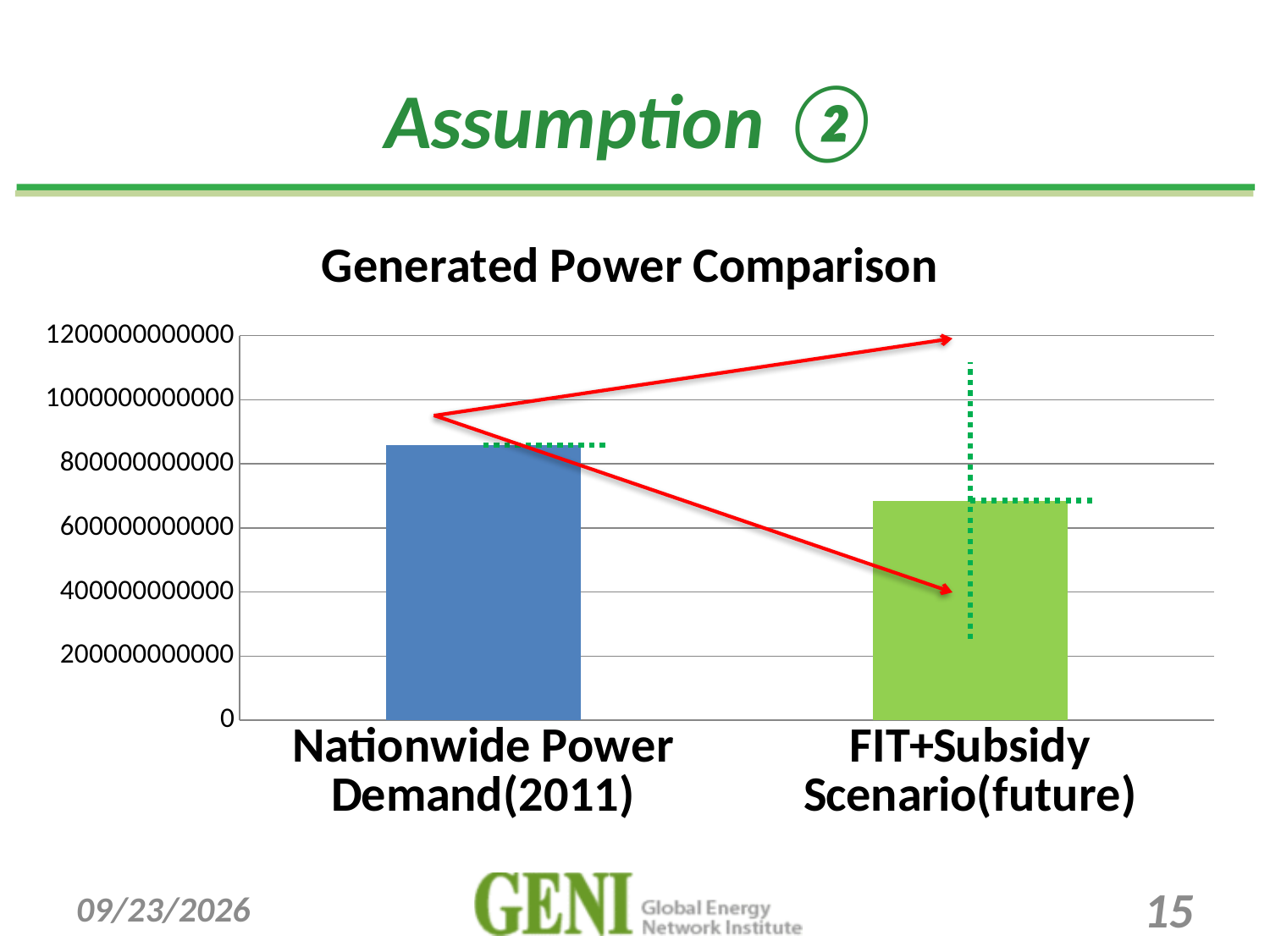
What kind of chart is shown on the slide? bar chart Is the value for Nationwide Power Demand(2011) greater or less than 1000000000000? less Which category has the highest value? Nationwide Power Demand(2011) Which is larger, the value for Nationwide Power Demand(2011) or the value for FIT+Subsidy Scenario(future)? Nationwide Power Demand(2011) What colour is the bar for FIT+Subsidy Scenario(future)? green Is the value for FIT+Subsidy Scenario(future) greater or less than 600000000000? greater What is the title of the chart? Generated Power Comparison Is the value for Nationwide Power Demand(2011) greater or less than 800000000000? greater Which category has the lowest value? FIT+Subsidy Scenario(future) Do the values rise or fall from the left bar to the right bar? fall How many categories are plotted in the chart? 2